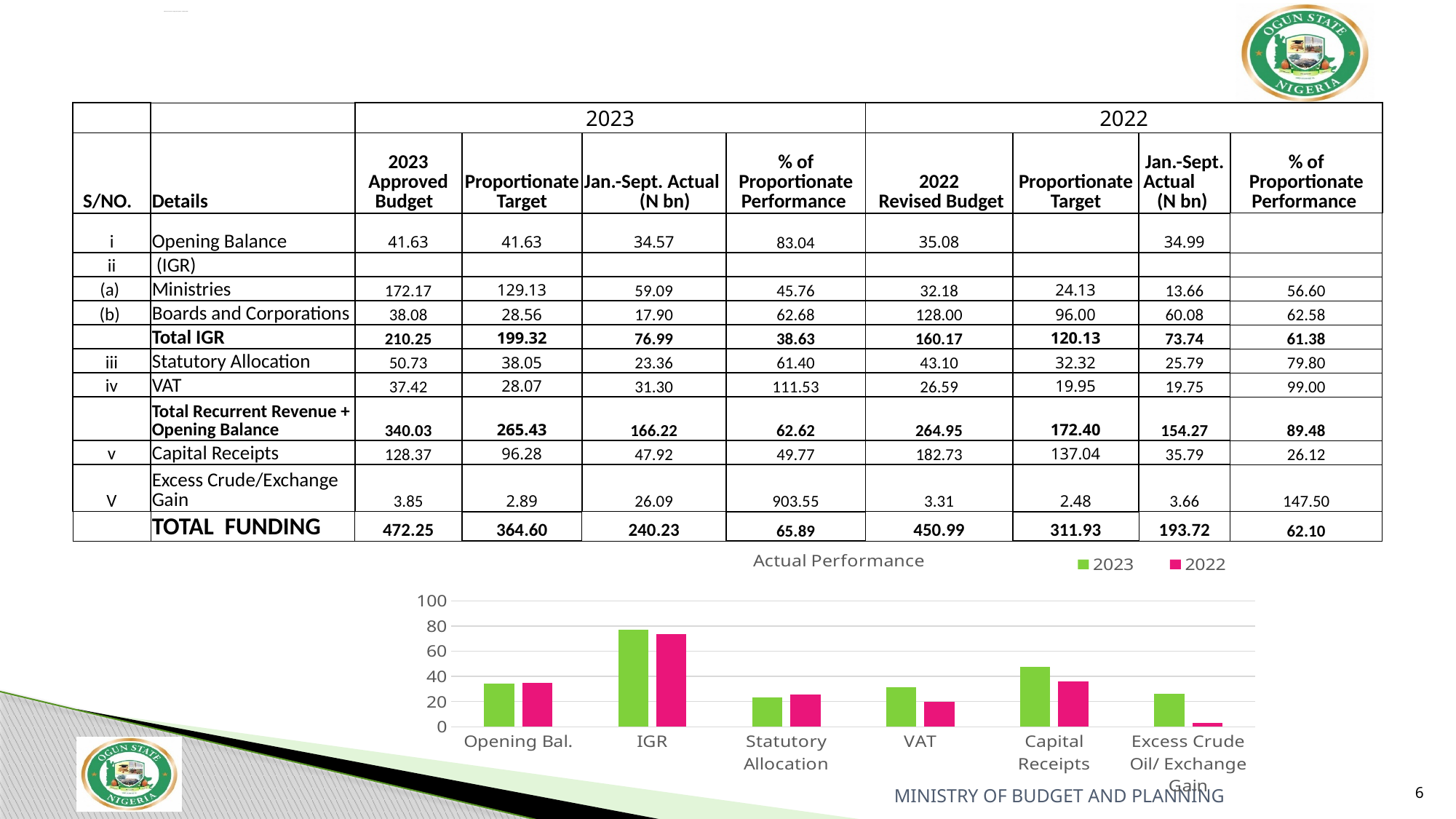
Is the 2023 value for IGR greater or less than 60? greater For Capital Receipts, which series has the larger bar, 2023 or 2022? 2023 How many series does the chart legend list? 2 For VAT, which series has the larger bar, 2023 or 2022? 2023 Which category has the lowest 2022 bar in the chart? Excess Crude Oil/ Exchange Gain Which category has the highest 2023 bar in the chart? IGR How many categories are shown on the x axis of the chart? 6 What is the title of the chart? Actual Performance Is the 2023 value for Capital Receipts greater or less than 40? greater Which colour represents the 2022 series in the chart? pink Is the 2022 value for Excess Crude Oil/ Exchange Gain greater or less than 20? less What kind of chart is shown on the slide? bar chart